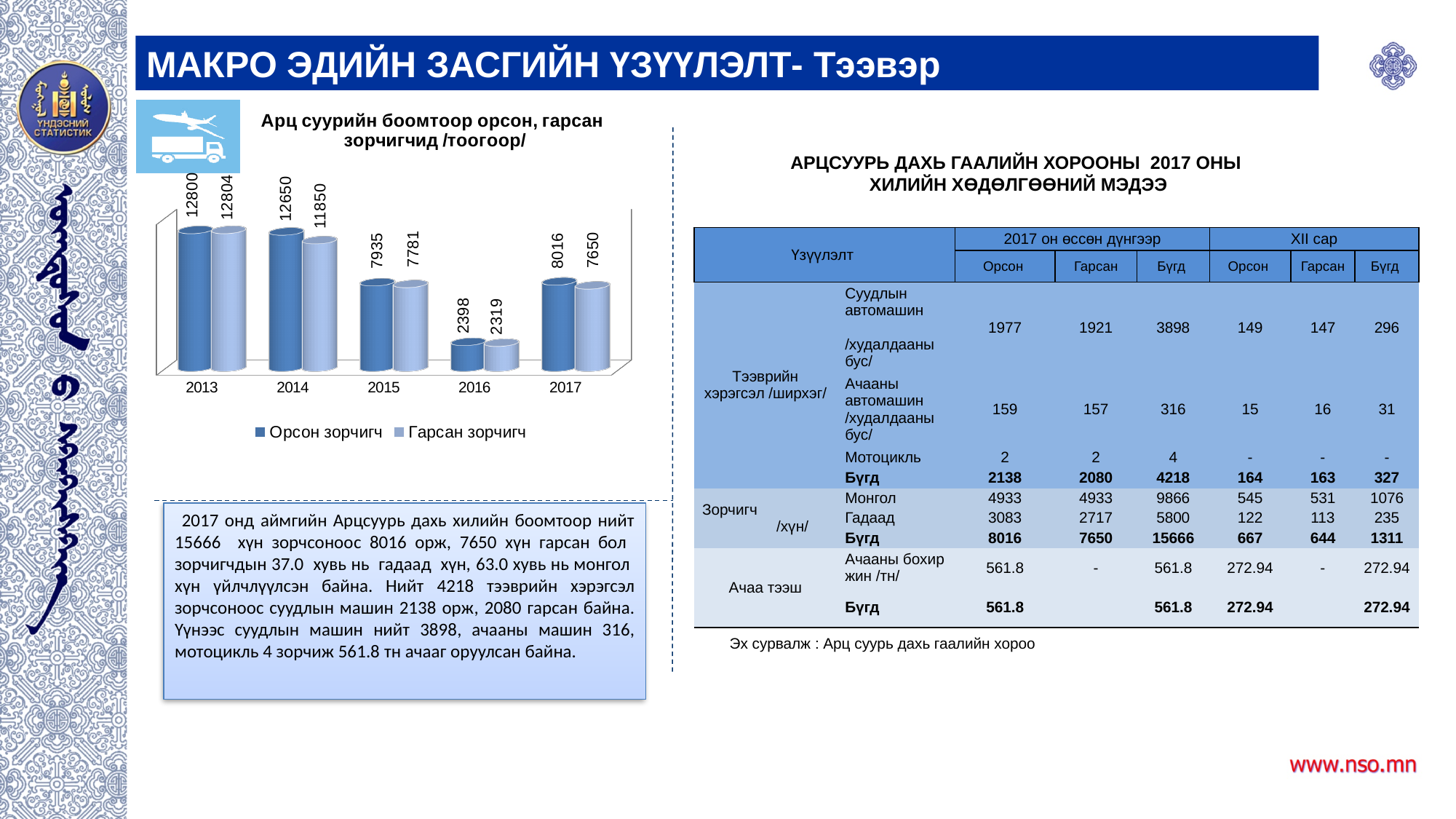
Does Орсон зорчигч rise or fall from 2013 to 2016? fall What is the value of Орсон зорчигч in 2017? 8016 What is the title of the chart? Арц суурийн боомтоор орсон, гарсан зорчигчид /тоогоор/ How many series does the chart legend list? 2 What is the value of Гарсан зорчигч in 2014? 11850 What is the value of Гарсан зорчигч in 2016? 2319 What type of chart is shown on the slide? bar chart What is the difference between Орсон зорчигч and Гарсан зорчигч in 2014? 800 In which year is Гарсан зорчигч the lowest? 2016 Which is larger in 2015, Орсон зорчигч or Гарсан зорчигч? Орсон зорчигч In which year is Орсон зорчигч the highest? 2013 How many years are shown on the x axis of the chart? 5